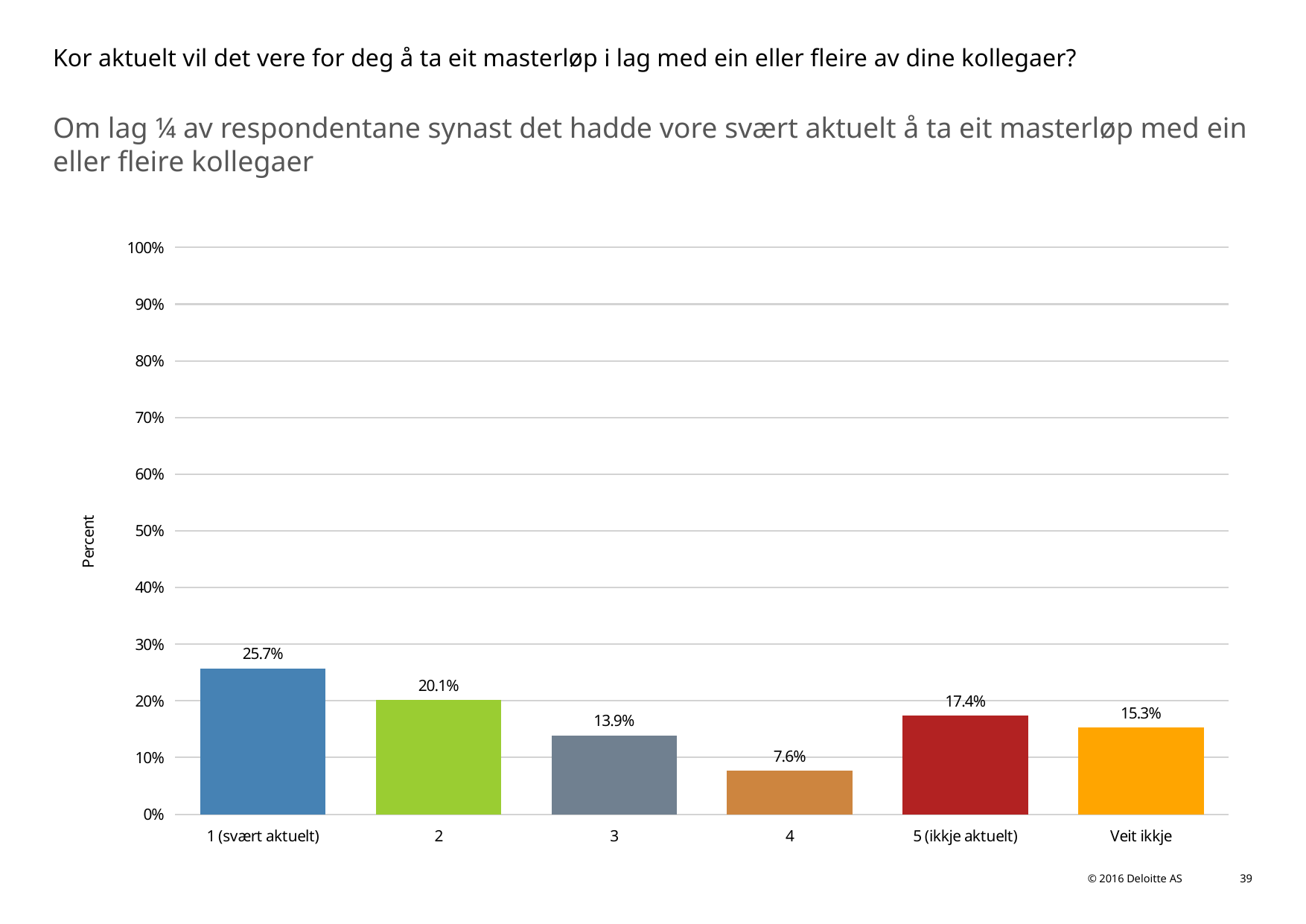
What is the difference between the values for "1 (svært aktuelt)" and "2"? 5.6% How many categories are shown on the x axis? 6 What kind of chart is shown on the slide? bar chart Is the value for "3" greater or less than 20%? less What is the value for the category "4"? 7.6% What is the label of the y axis? Percent Which category has the highest value? 1 (svært aktuelt) What is the value for the category "Veit ikkje"? 15.3% What is the value for the category "5 (ikkje aktuelt)"? 17.4% Which category has the lowest value? 4 What is the value for the category "1 (svært aktuelt)"? 25.7% Which is larger, the value for "5 (ikkje aktuelt)" or the value for "Veit ikkje"? 5 (ikkje aktuelt)